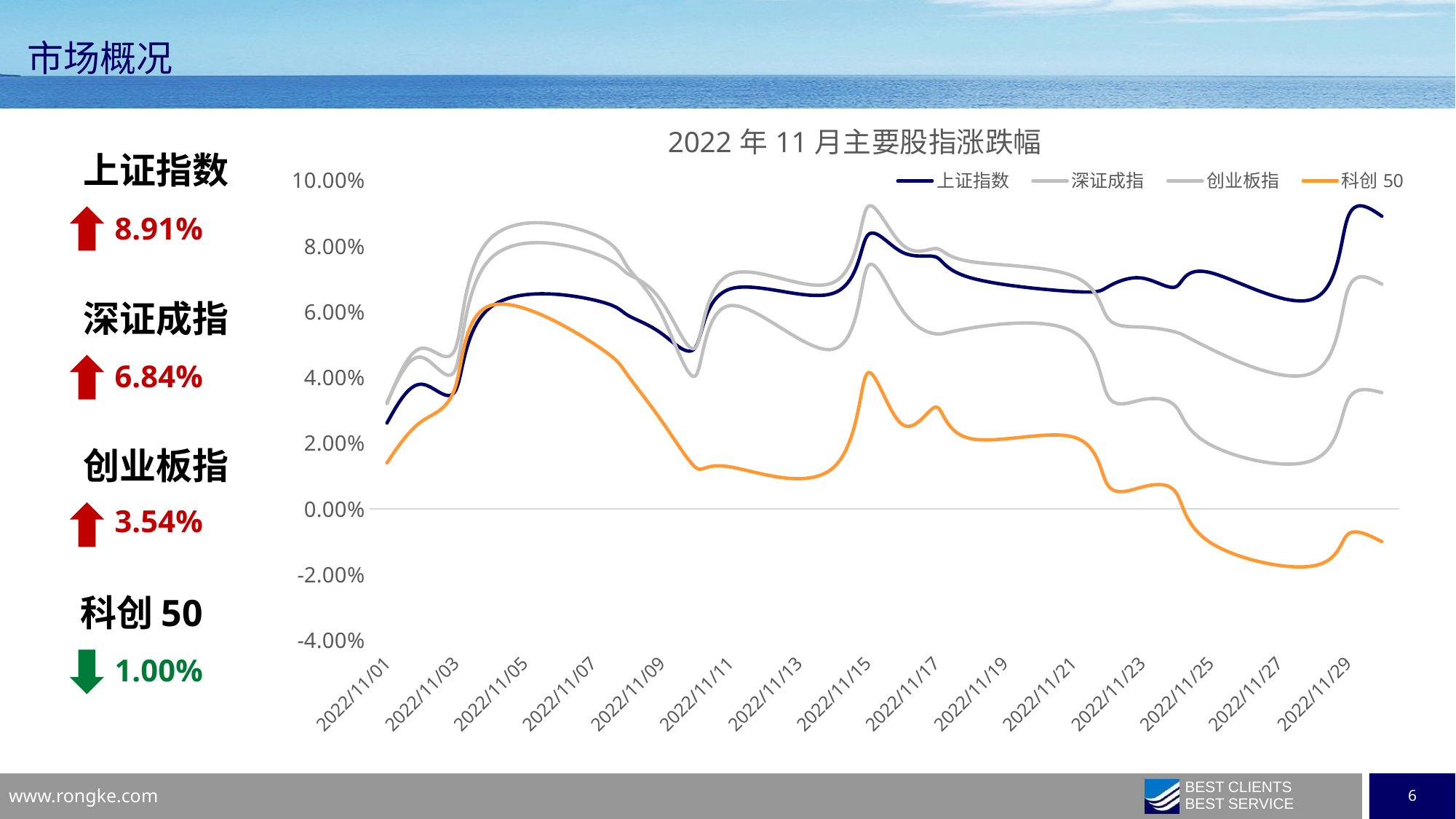
What is the title of the chart? 2022 年 11 月主要股指涨跌幅 On 2022/11/29, which series has the higher value, 上证指数 or 科创 50? 上证指数 What colour is the 科创 50 line in the chart? orange What kind of chart is shown on the slide? line chart Is the value for 科创 50 on 2022/11/01 greater or less than 2.00%? less How many series does the chart legend list? 4 Is the value for 科创 50 on 2022/11/27 greater or less than 0.00%? less Is the value for 上证指数 on 2022/11/29 greater or less than 8.00%? greater Does the 科创 50 line rise or fall between 2022/11/05 and 2022/11/09? fall Which series has the highest value on 2022/11/29? 上证指数 Which series has the lowest value at the end of the month (2022/11/29)? 科创 50